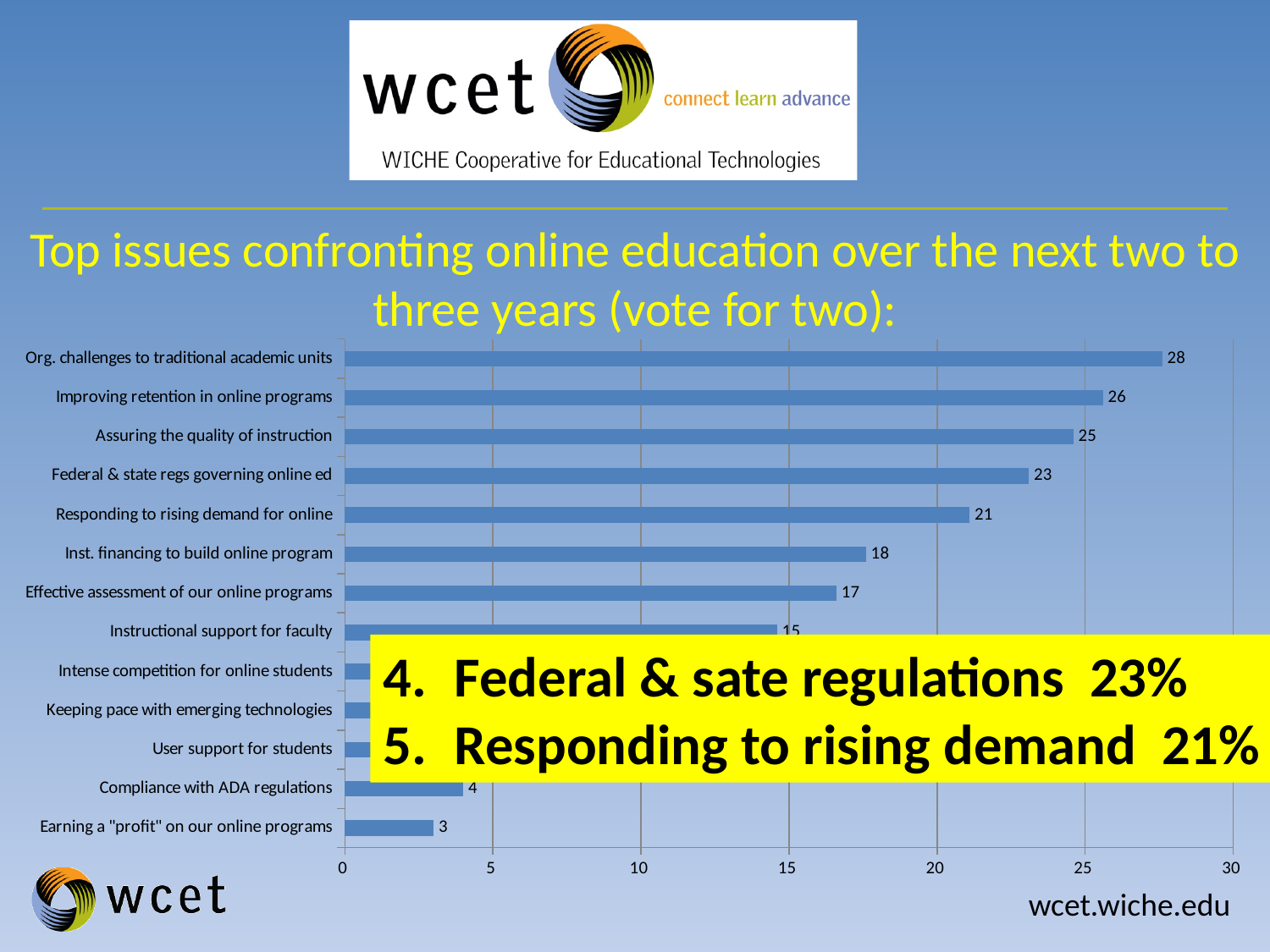
What is the value for "Federal & state regs governing online ed"? 23 What type of chart is shown on the slide? bar chart Which category has the highest value? Org. challenges to traditional academic units Is the value for "Compliance with ADA regulations" greater or less than 5? less What is the value for "Improving retention in online programs"? 26 Which category has the lowest value? Earning a "profit" on our online programs Which is larger, the value for "Responding to rising demand for online" or the value for "Effective assessment of our online programs"? Responding to rising demand for online What is the title of the chart? Top issues confronting online education over the next two to three years (vote for two): What is the difference between the values for "Assuring the quality of instruction" and "Inst. financing to build online program"? 7 What is the value for "Earning a "profit" on our online programs"? 3 How many categories are shown on the chart? 13 What is the value for "Org. challenges to traditional academic units"? 28